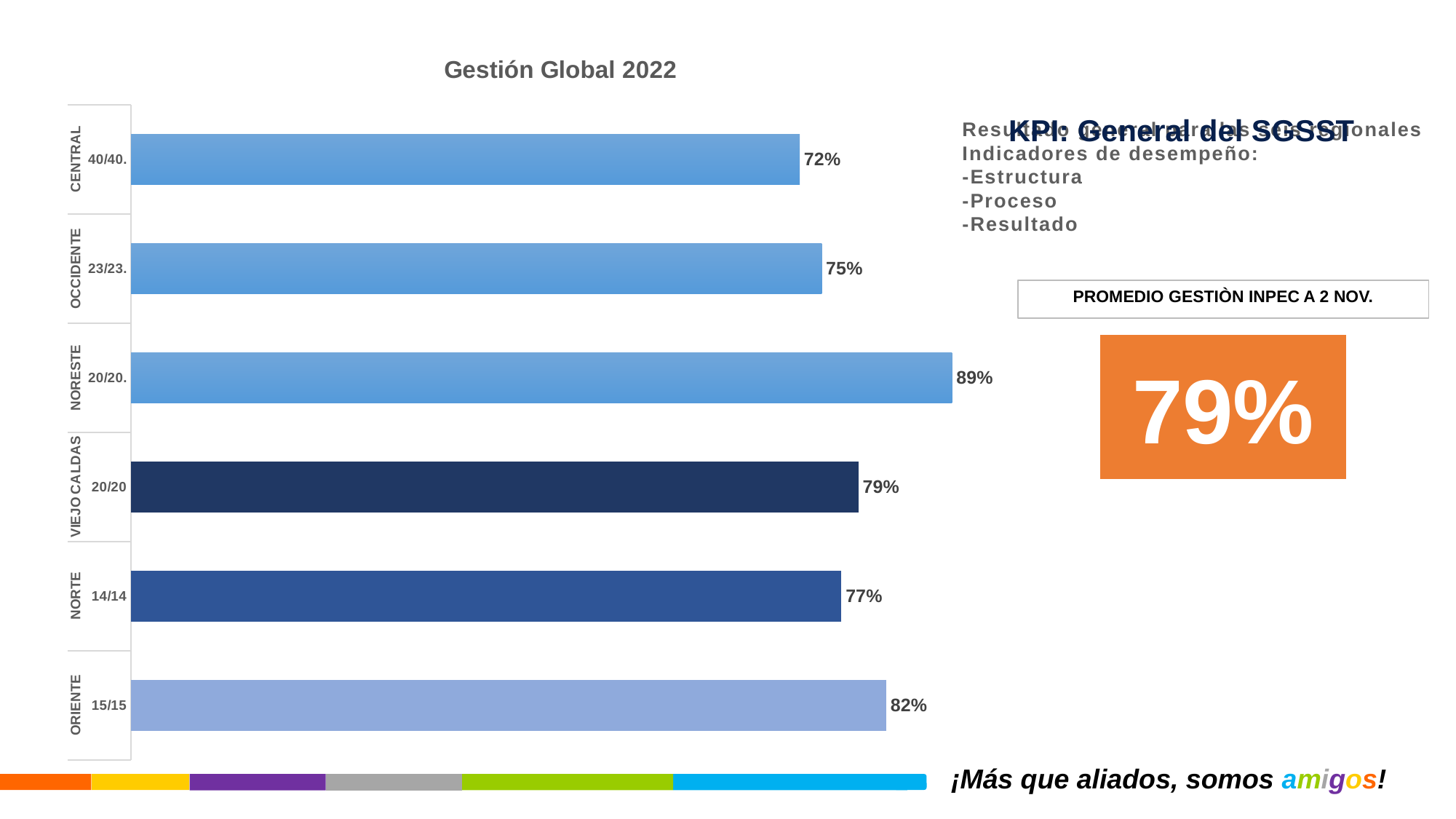
What kind of chart is the Gestión Global 2022 chart? Bar chart What is the value for CENTRAL in the Gestión Global 2022 chart? 72% Which region has the highest value in the Gestión Global 2022 chart? NORESTE What is the value for VIEJO CALDAS in the Gestión Global 2022 chart? 79% What is the difference between the values for ORIENTE and NORTE in the Gestión Global 2022 chart? 5% Which region has the lowest value in the Gestión Global 2022 chart? CENTRAL What is the title of the chart on the slide? Gestión Global 2022 What is the value for NORESTE in the Gestión Global 2022 chart? 89% What is the value for ORIENTE in the Gestión Global 2022 chart? 82% What is the difference between the values for NORESTE and CENTRAL in the Gestión Global 2022 chart? 17% Which is larger in the Gestión Global 2022 chart, the value for NORTE or the value for OCCIDENTE? NORTE How many regions are shown in the Gestión Global 2022 chart? 6